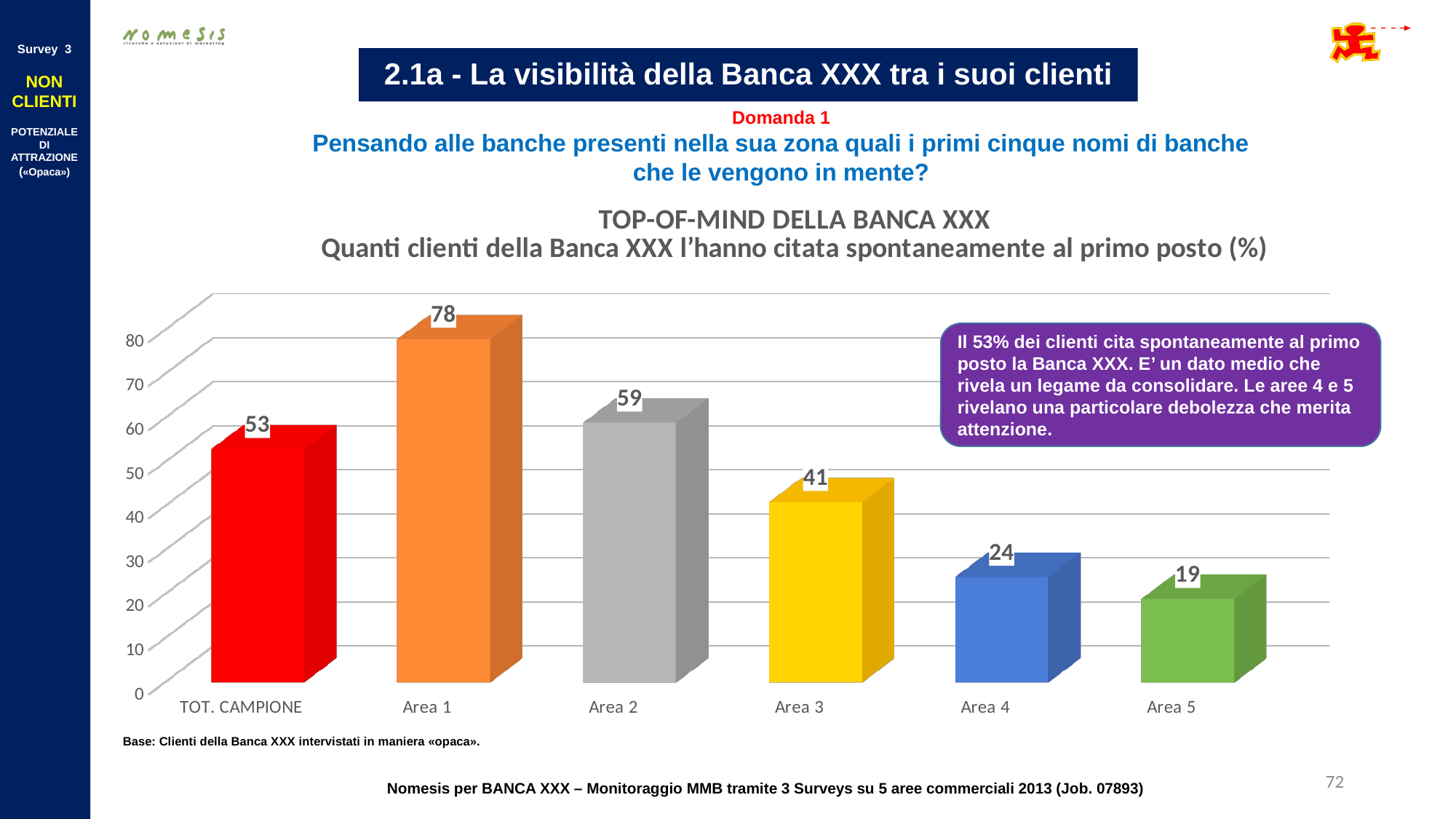
What colour is the bar for Area 3? yellow Which is larger, the value for Area 2 or the value for Area 3? Area 2 What is the difference between the values for Area 3 and Area 4? 17 What is the difference between the values for Area 1 and Area 2? 19 Which category has the highest value? Area 1 What is the value for TOT. CAMPIONE? 53 How many categories are shown on the x axis? 6 Is the value for Area 4 greater or less than 30? less What is the value for Area 5? 19 Which category has the lowest value? Area 5 What kind of chart is shown on the slide? bar chart What is the value for Area 1? 78